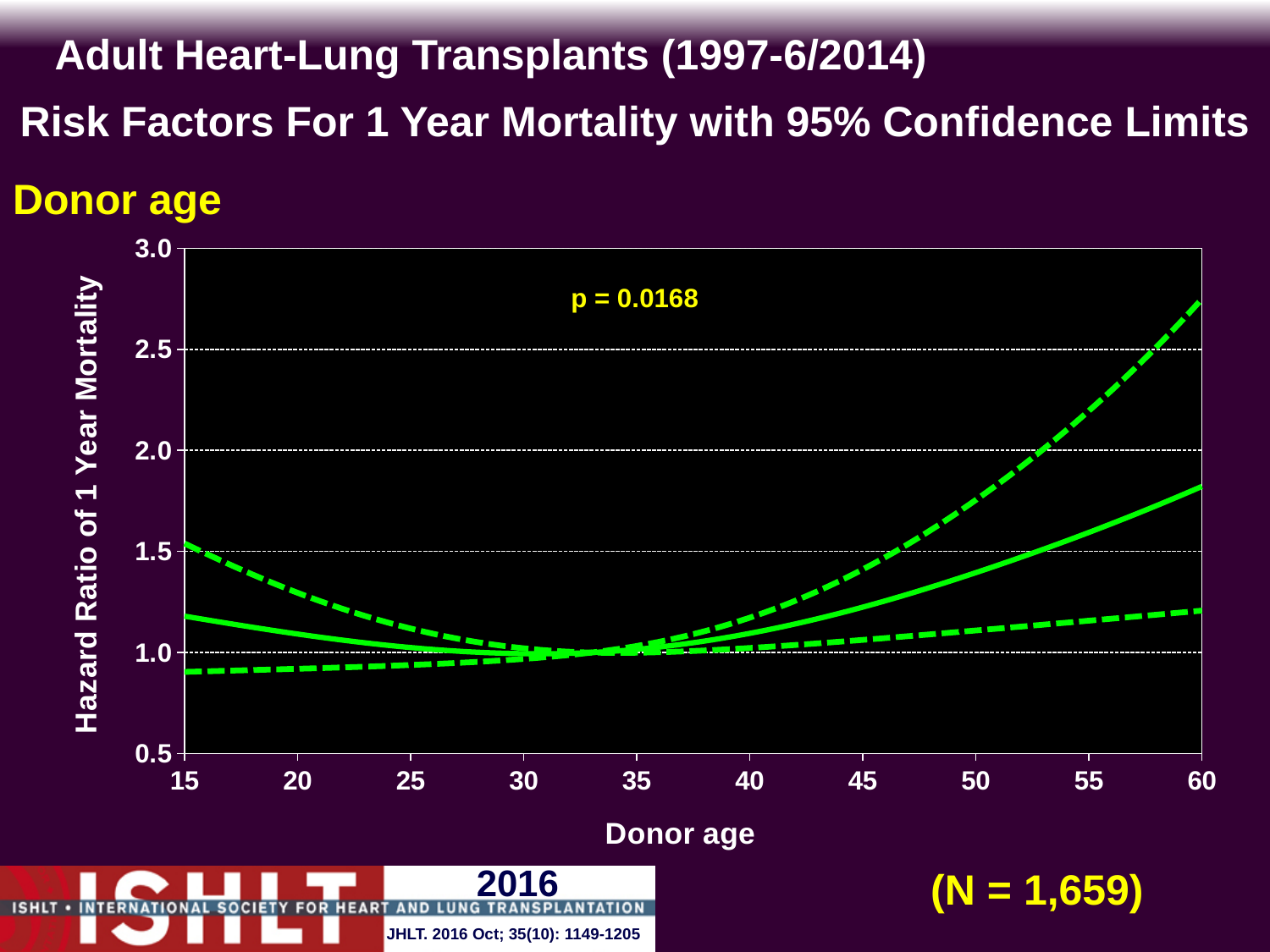
What kind of chart is shown on the slide? line chart How many lines are plotted on the chart? 3 Is the upper dashed confidence limit at donor age 60 greater or less than 2.5? greater What is the sample size (N) shown on the slide? N = 1,659 What is the label of the x axis? Donor age Is the hazard ratio on the solid line at donor age 60 greater or less than 1.5? greater Does the solid hazard ratio line rise or fall as donor age increases from 35 to 60? rises How many tick labels are shown on the x axis? 10 Is the lower dashed confidence limit at donor age 15 greater or less than 1.0? less What p-value is printed on the chart? p = 0.0168 What is the label of the y axis? Hazard Ratio of 1 Year Mortality